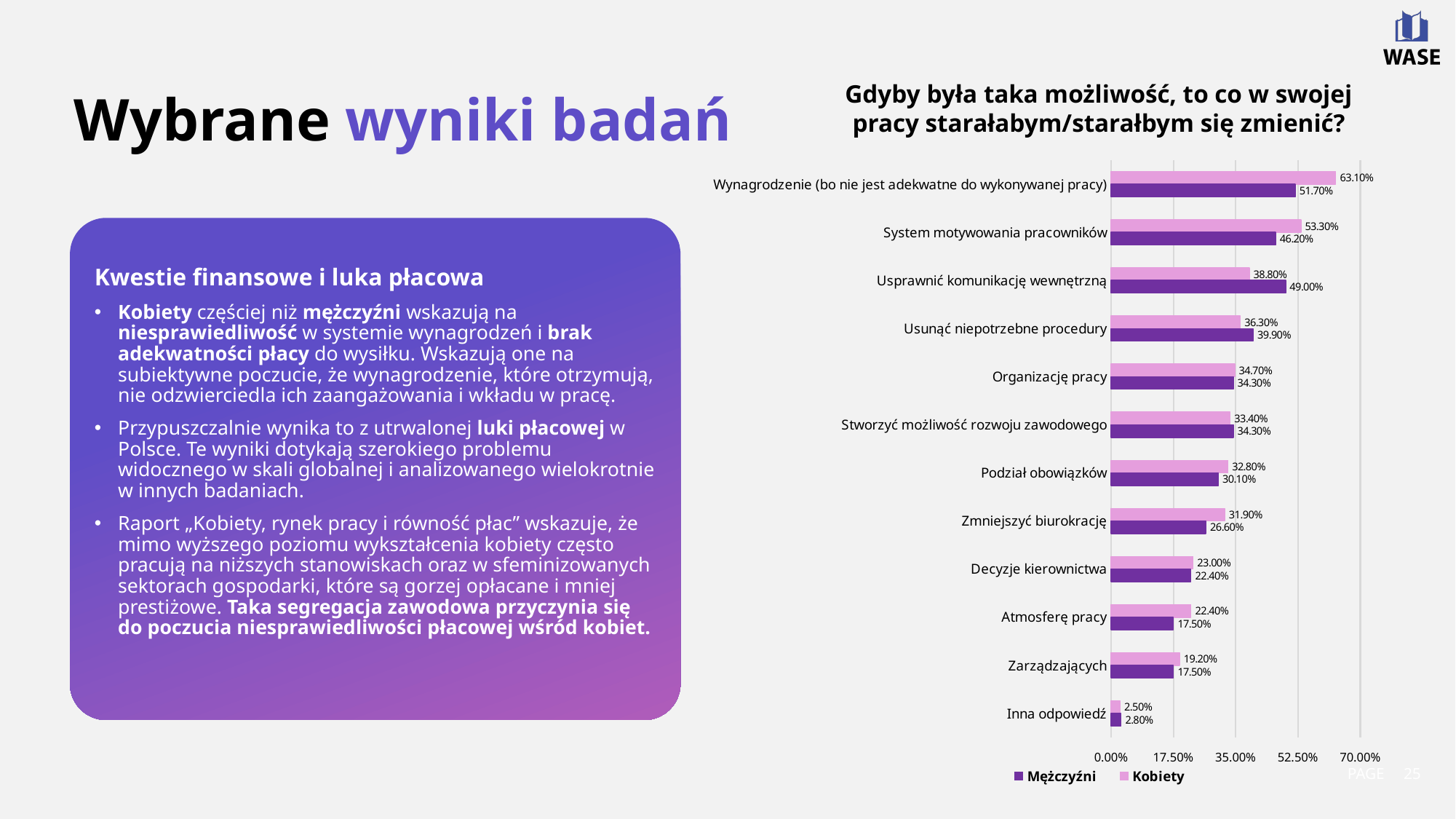
Is the Kobiety value for 'System motywowania pracowników' greater or less than 52.50%? greater How many categories are shown in the chart? 12 Which category has the lowest Mężczyźni value? Inna odpowiedź For 'Usunąć niepotrzebne procedury', which series has the larger value, Kobiety or Mężczyźni? Mężczyźni What type of chart is shown on the slide? Bar chart Which series is shown in the lighter pink colour in the chart? Kobiety How many series does the chart legend list? 2 What is the Kobiety value for 'Wynagrodzenie (bo nie jest adekwatne do wykonywanej pracy)'? 63.10% What is the Mężczyźni value for 'Usprawnić komunikację wewnętrzną'? 49.00% What is the Mężczyźni value for 'Zmniejszyć biurokrację'? 26.60% Which category has the highest Kobiety value? Wynagrodzenie (bo nie jest adekwatne do wykonywanej pracy) What is the difference between the Kobiety and Mężczyźni values for 'Wynagrodzenie (bo nie jest adekwatne do wykonywanej pracy)'? 11.40%